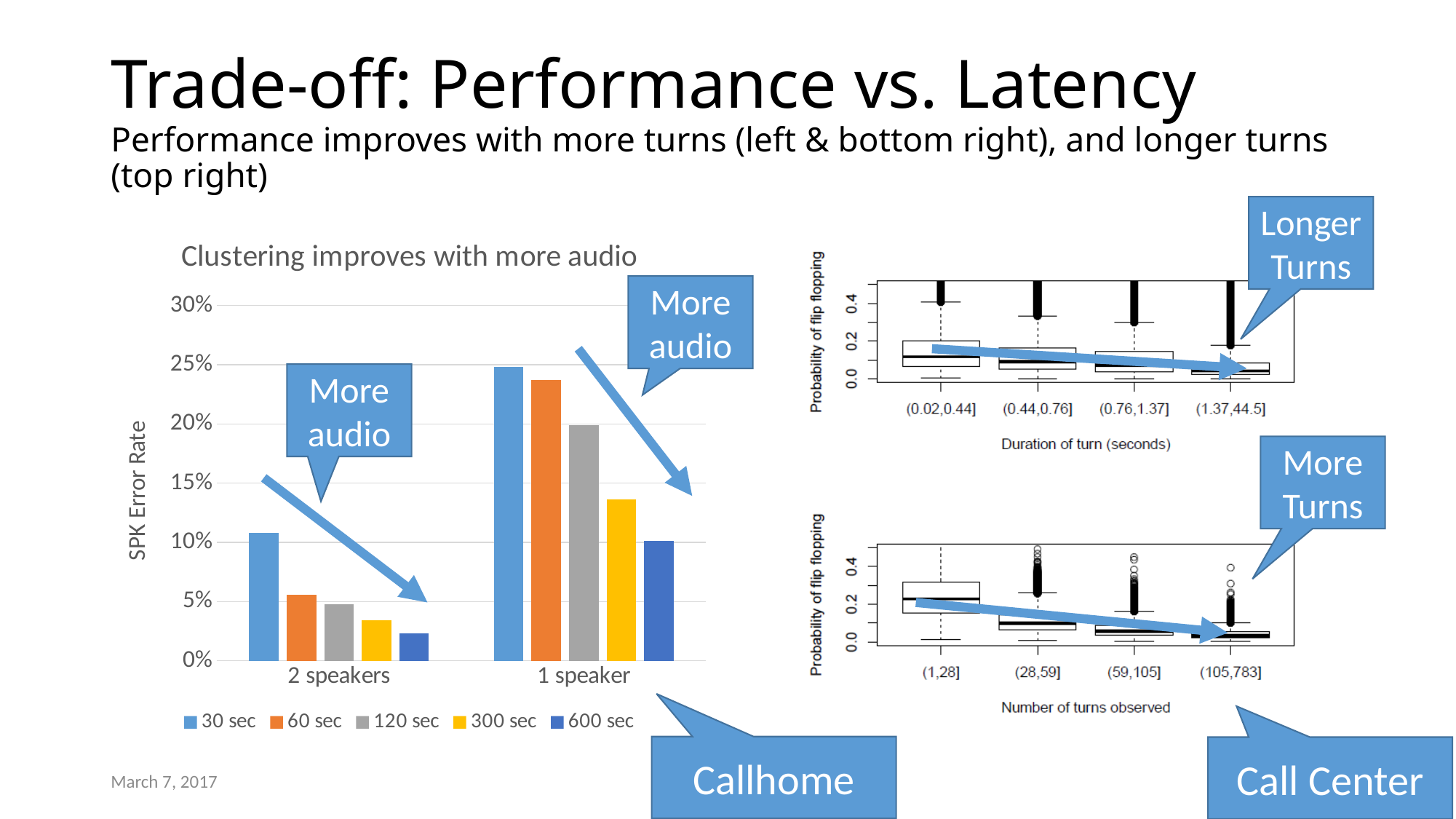
In the chart titled "Clustering improves with more audio", how many series does the legend list? 5 In the chart titled "Clustering improves with more audio", how many categories are shown on the x axis? 2 In the chart titled "Clustering improves with more audio", which series has the lowest SPK Error Rate for 2 speakers? 600 sec In the chart titled "Clustering improves with more audio", does the SPK Error Rate rise or fall as the audio duration increases from 30 sec to 600 sec within each category? fall In the bottom right chart with x axis "Number of turns observed", what is the label of the y axis? Probability of flip flopping In the chart titled "Clustering improves with more audio", what is the label of the y axis? SPK Error Rate In the top right chart with x axis "Duration of turn (seconds)", how many duration bins are shown? 4 In the chart titled "Clustering improves with more audio", what kind of chart is it? bar chart In the chart titled "Clustering improves with more audio", which is larger: the 300 sec value for 1 speaker or the 30 sec value for 2 speakers? 300 sec value for 1 speaker In the chart titled "Clustering improves with more audio", is the SPK Error Rate for 30 sec with 2 speakers greater or less than 10%? greater In the chart titled "Clustering improves with more audio", which series has the highest SPK Error Rate for 1 speaker? 30 sec